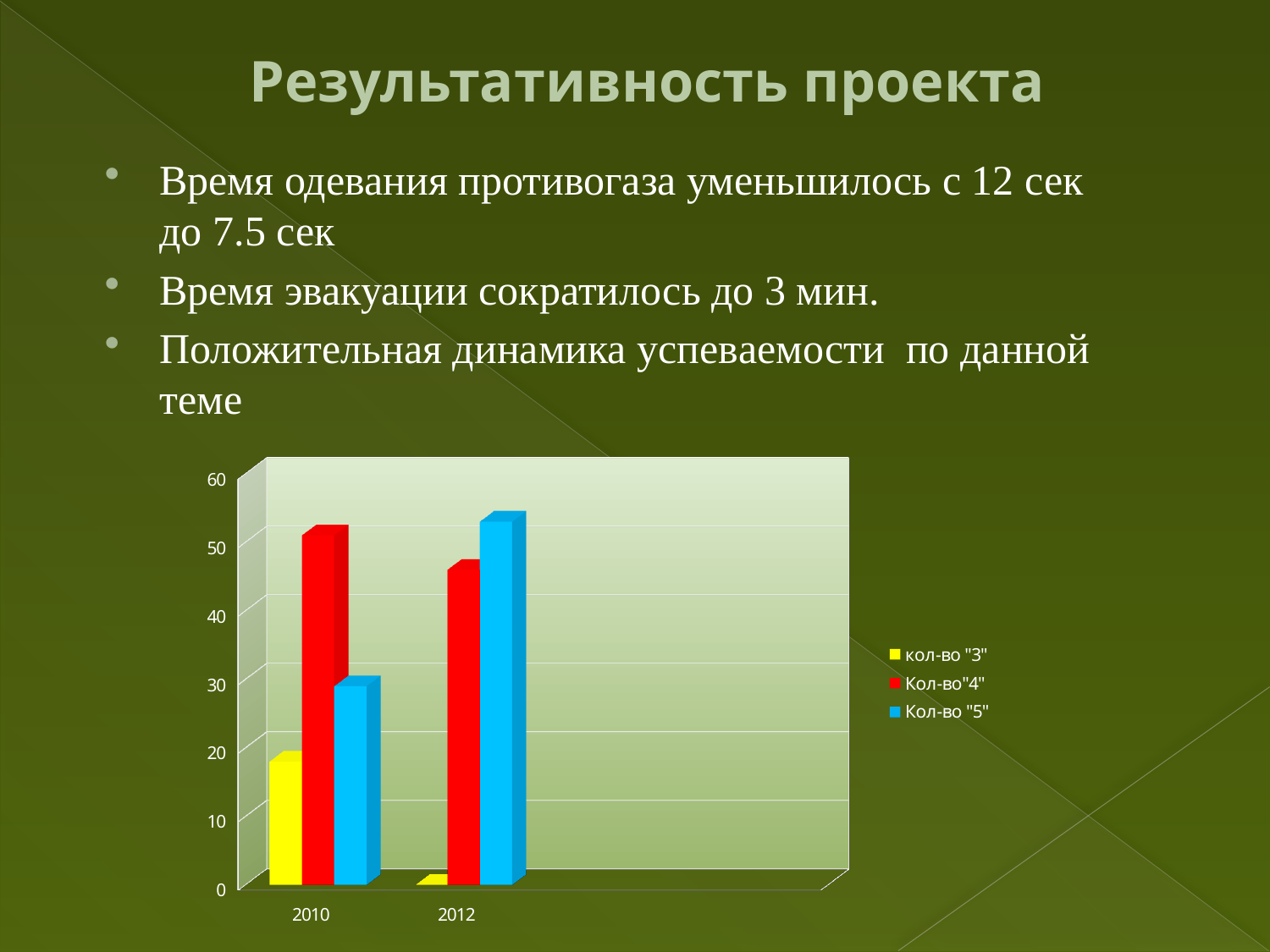
Which series has the highest value in 2010? Кол-во"4" Which is larger in 2012: Кол-во"4" or Кол-во "5"? Кол-во "5" Which year has the larger value for кол-во "3": 2010 or 2012? 2010 Is the value for кол-во "3" in 2012 greater or less than 10? less Which series has the lowest value in 2012? кол-во "3" Is the value for Кол-во "5" in 2010 greater or less than 40? less What kind of chart is shown on the slide? bar chart How many categories are shown on the x axis of the chart? 2 Does the value for Кол-во "5" rise or fall from 2010 to 2012? rise What colour represents the series Кол-во"4" in the chart? red How many series does the chart legend list? 3 Is the value for Кол-во"4" in 2010 greater or less than 40? greater